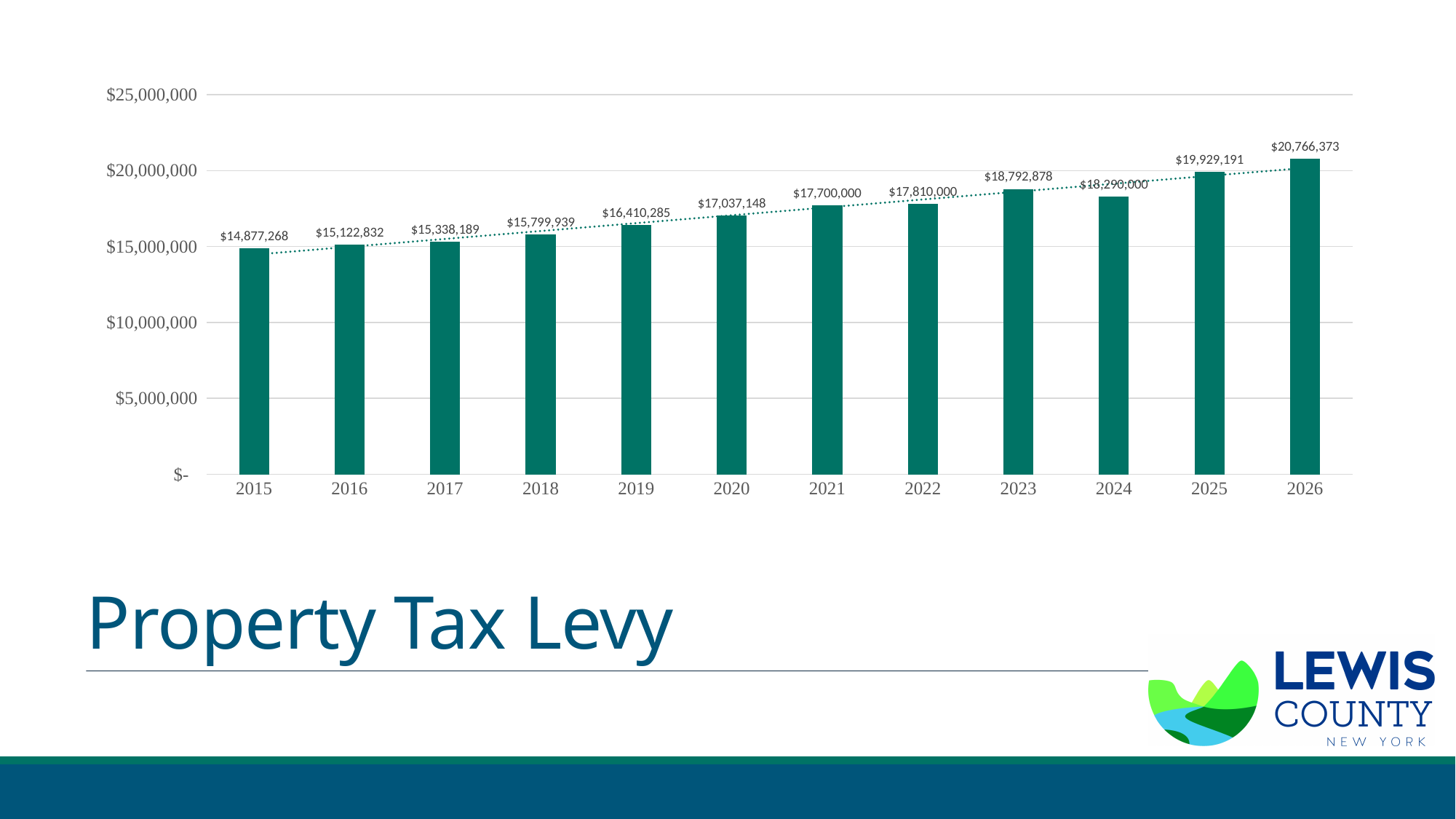
Which year has the lowest property tax levy? 2015 What is the property tax levy for 2019? $16,410,285 What is the property tax levy for 2015? $14,877,268 What kind of chart is shown on the slide? Bar chart What is the difference between the property tax levy in 2026 and in 2015? $5,889,105 What is the property tax levy for 2021? $17,700,000 What is the property tax levy for 2026? $20,766,373 Which year has a larger property tax levy, 2018 or 2023? 2023 What is the difference between the property tax levy in 2022 and in 2021? $110,000 How many years are shown on the chart? 12 Is the value for 2023 greater or less than $20,000,000? less Which year has the highest property tax levy? 2026